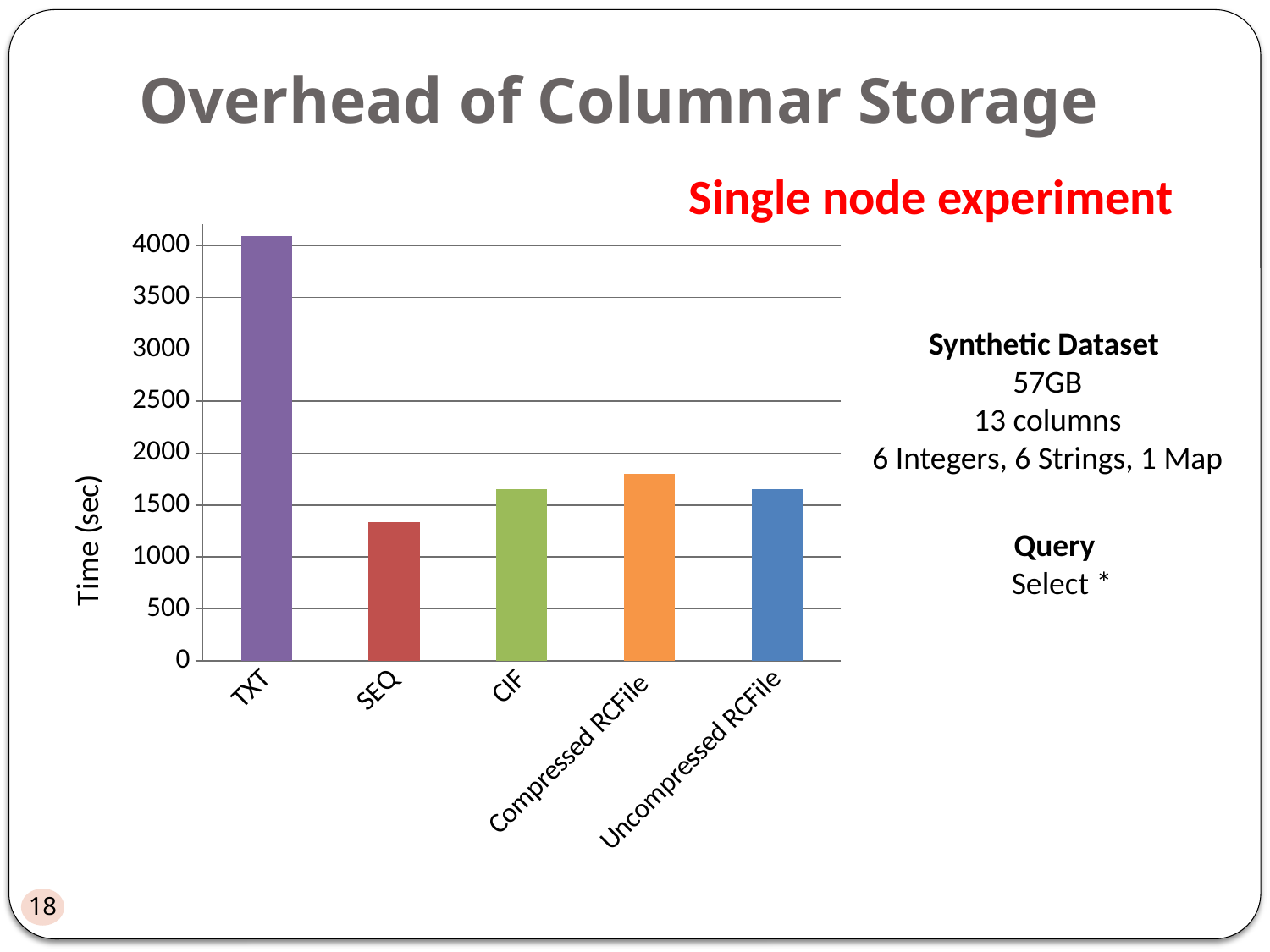
Is the value for SEQ greater or less than 1500? less Which is larger, the value for Compressed RCFile or the value for SEQ? Compressed RCFile Which category has the highest time in the chart? TXT What is the label on the y axis of the chart? Time (sec) Which is larger, the value for TXT or the value for SEQ? TXT Is the value for CIF greater or less than 1500? greater Is the value for TXT greater or less than 4000? greater How many categories are plotted on the x axis of the chart? 5 Which category has the lowest time in the chart? SEQ What kind of chart is shown on the slide? bar chart